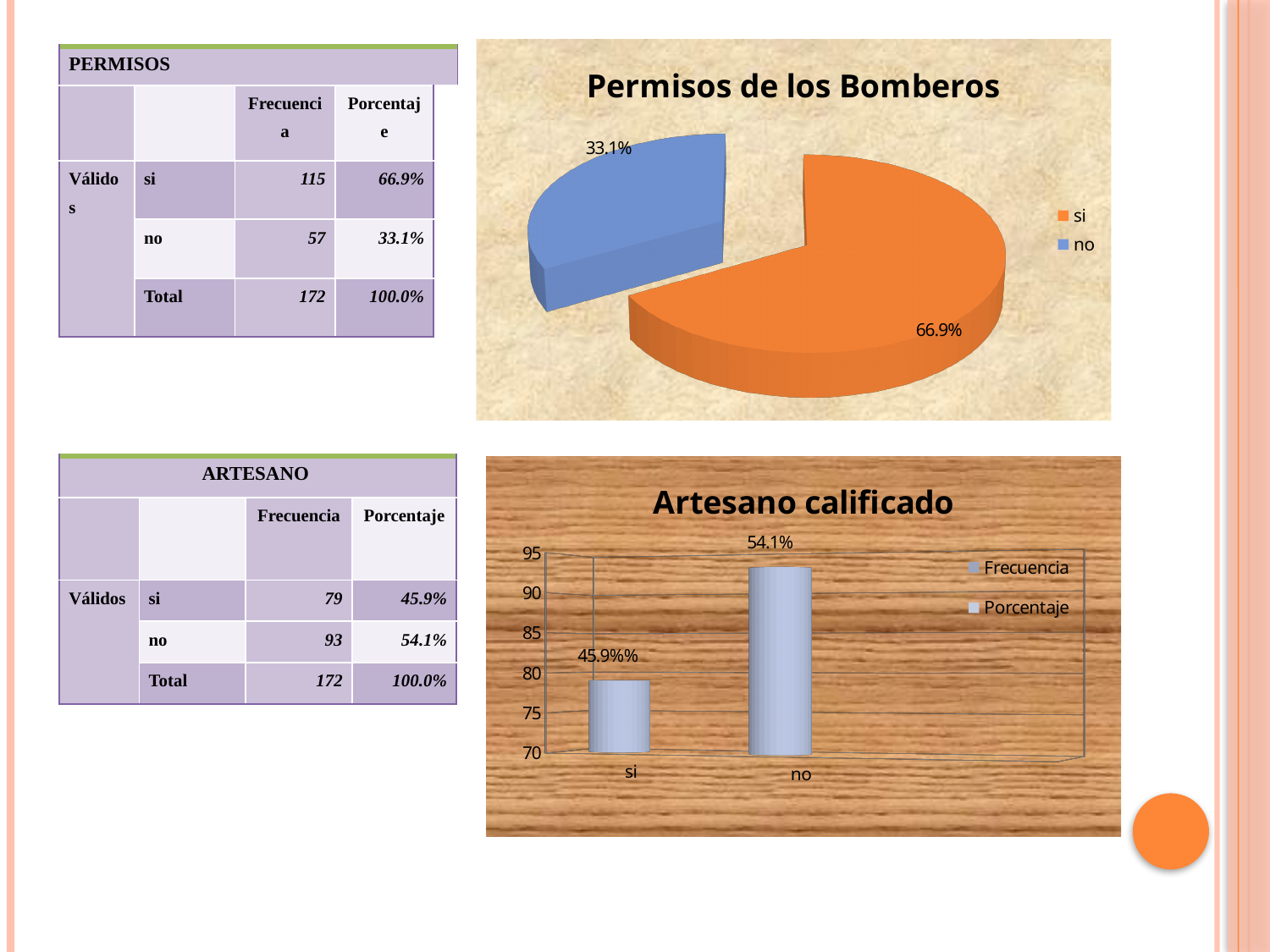
In the 'Permisos de los Bomberos' chart, what colour is the 'si' slice? orange In the 'Artesano calificado' chart, which category has the taller bar? no In the 'Artesano calificado' chart, is the bar for 'no' greater or less than 90? greater What kind of chart is 'Artesano calificado'? bar chart In the 'Permisos de los Bomberos' chart, what is the difference in percentage points between the 'si' and 'no' slices? 33.8 In the 'Permisos de los Bomberos' chart, which slice is the largest? si In the 'Permisos de los Bomberos' chart, what percentage is shown for the 'si' slice? 66.9% In the 'Permisos de los Bomberos' chart, what percentage is shown for the 'no' slice? 33.1% What kind of chart is 'Permisos de los Bomberos'? pie chart How many slices does the 'Permisos de los Bomberos' pie chart have? 2 How many series does the legend of the 'Artesano calificado' chart list? 2 In the 'Artesano calificado' chart, what data label is shown above the 'no' bar? 54.1%